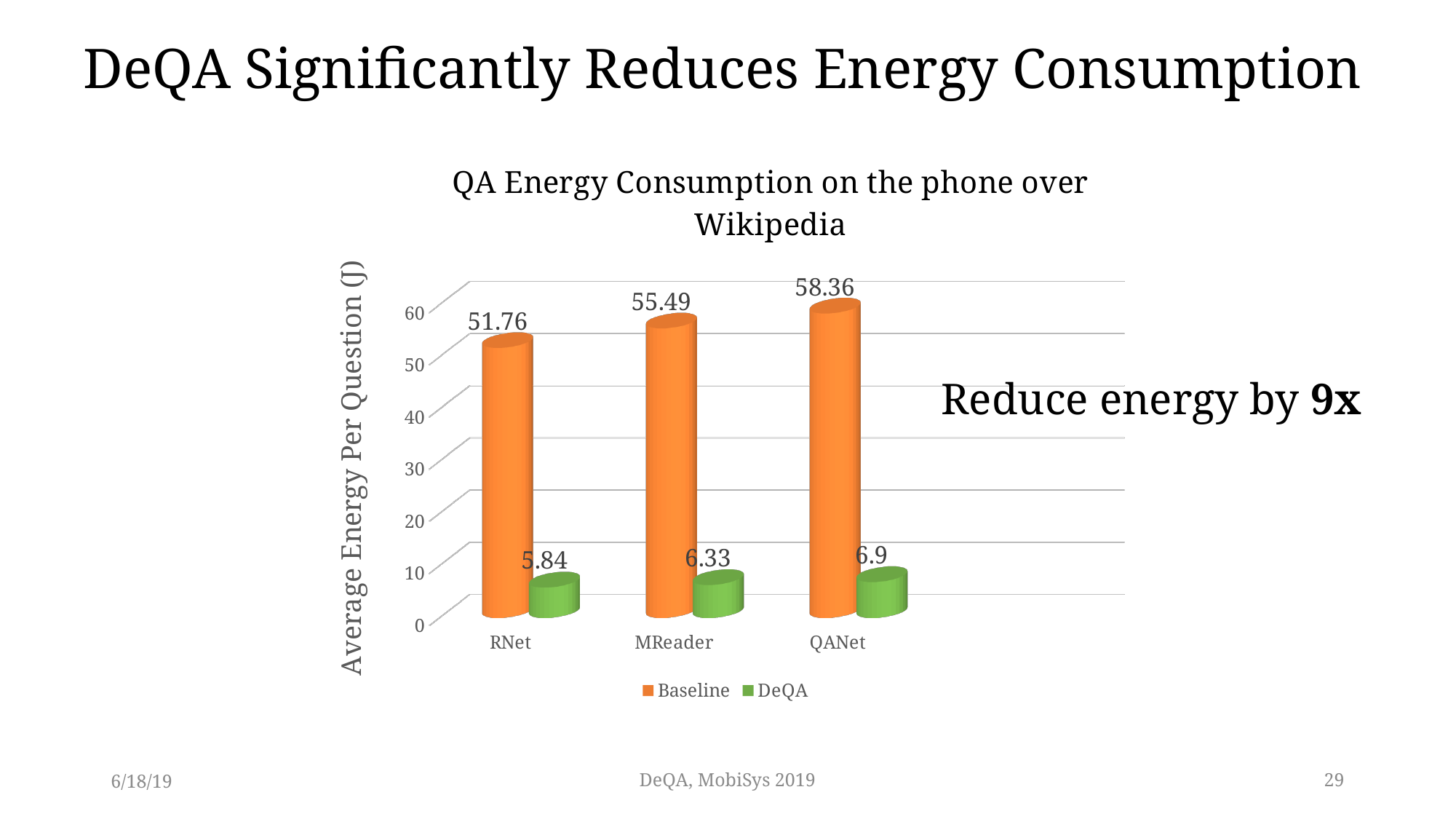
How many series does the legend list? 2 What is the label of the vertical axis? Average Energy Per Question (J) How many models are shown on the x axis? 3 What is the Baseline energy consumption for RNet? 51.76 What is the Baseline value for QANet? 58.36 What kind of chart is shown? Bar chart Which model has the highest Baseline energy consumption? QANet Which model has the lowest DeQA energy consumption? RNet Which is larger for MReader: the Baseline value or the DeQA value? Baseline What is the difference between the Baseline and DeQA values for RNet? 45.92 What is the DeQA value for QANet? 6.9 What is the DeQA energy consumption for MReader? 6.33